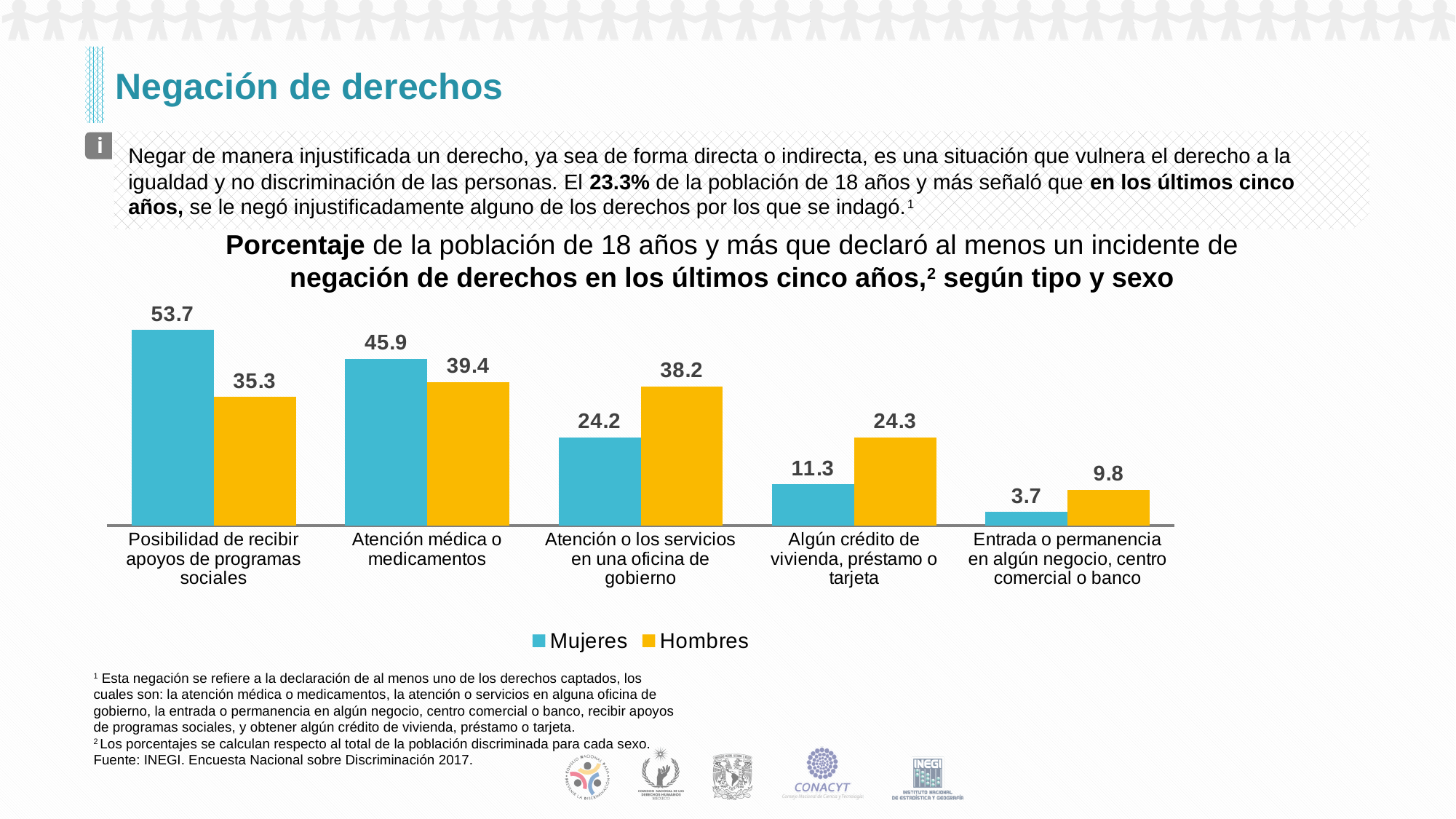
What is the value for Hombres in the category 'Atención médica o medicamentos'? 39.4 Which category has the lowest value for Hombres? Entrada o permanencia en algún negocio, centro comercial o banco What is the difference between Hombres and Mujeres in the category 'Atención o los servicios en una oficina de gobierno'? 14.0 What is the difference between Mujeres and Hombres in the category 'Posibilidad de recibir apoyos de programas sociales'? 18.4 Which colour represents the Hombres series in the chart? Yellow/orange What kind of chart is shown on the slide? Bar chart Which category has the highest value for Mujeres? Posibilidad de recibir apoyos de programas sociales How many categories are shown on the x axis of the chart? 5 What is the value for Hombres in the category 'Entrada o permanencia en algún negocio, centro comercial o banco'? 9.8 How many series does the legend list? 2 In the category 'Algún crédito de vivienda, préstamo o tarjeta', which is larger: Mujeres or Hombres? Hombres What is the value for Mujeres in the category 'Posibilidad de recibir apoyos de programas sociales'? 53.7